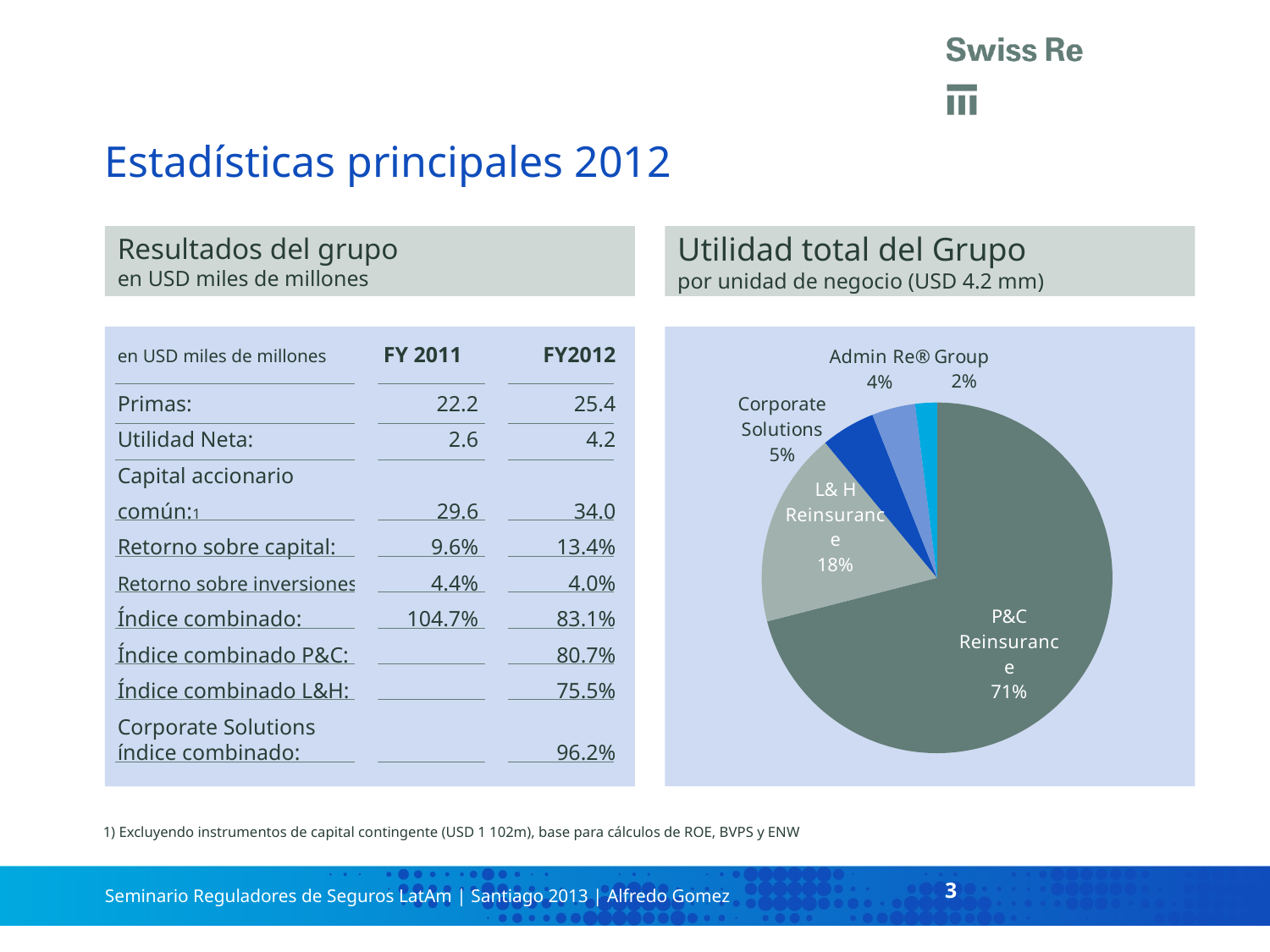
What percentage is shown for Corporate Solutions in the pie chart? 5% Which business unit has the largest slice of the pie? P&C Reinsurance What total amount in USD does the pie chart subtitle say the Group profit represents? USD 4.2 mm What share of the pie does P&C Reinsurance hold? 71% What percentage is shown for Admin Re® in the pie chart? 4% What kind of chart is shown under 'Utilidad total del Grupo'? pie chart Which business unit has the smallest slice of the pie? Group What is the difference in percentage points between P&C Reinsurance and L&H Reinsurance? 53 Which is larger in the pie chart, Corporate Solutions or Admin Re®? Corporate Solutions What share of the pie does L&H Reinsurance hold? 18% What percentage is shown for Group in the pie chart? 2% How many slices does the pie chart have? 5